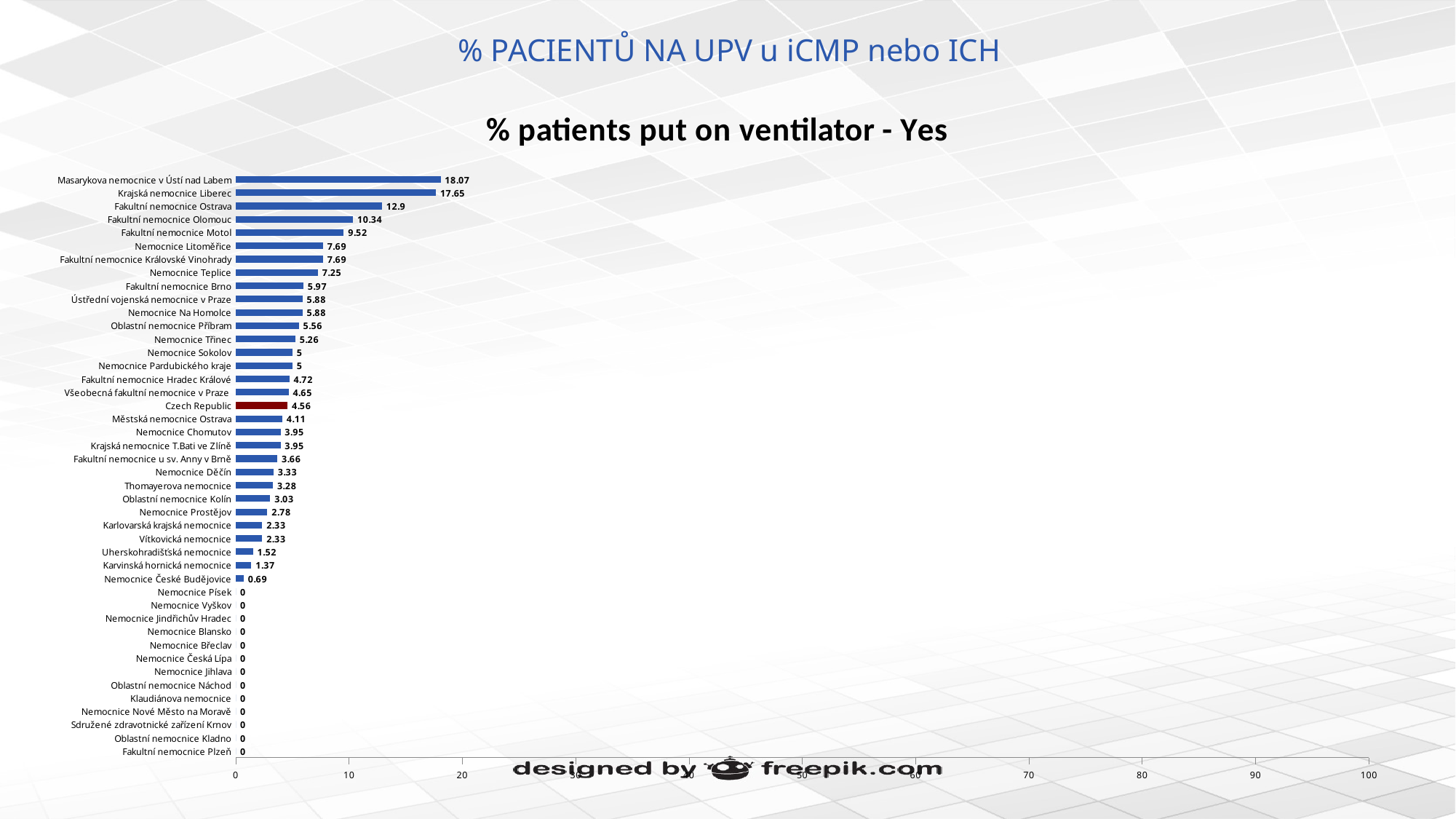
What is the value for Masarykova nemocnice v Ústí nad Labem? 18.07 Is the value for Krajská nemocnice Liberec greater or less than 10? greater Which bar is coloured dark red instead of blue? Czech Republic How many hospitals have a value of 0? 13 What is the value for Nemocnice České Budějovice? 0.69 Which hospital has the highest value? Masarykova nemocnice v Ústí nad Labem What is the difference between Fakultní nemocnice Motol and Czech Republic? 4.96 Which is larger, Fakultní nemocnice Ostrava or Fakultní nemocnice Olomouc? Fakultní nemocnice Ostrava What is the value for Czech Republic? 4.56 What is the difference between Masarykova nemocnice v Ústí nad Labem and Krajská nemocnice Liberec? 0.42 What kind of chart is shown? bar chart What is the value for Fakultní nemocnice Motol? 9.52